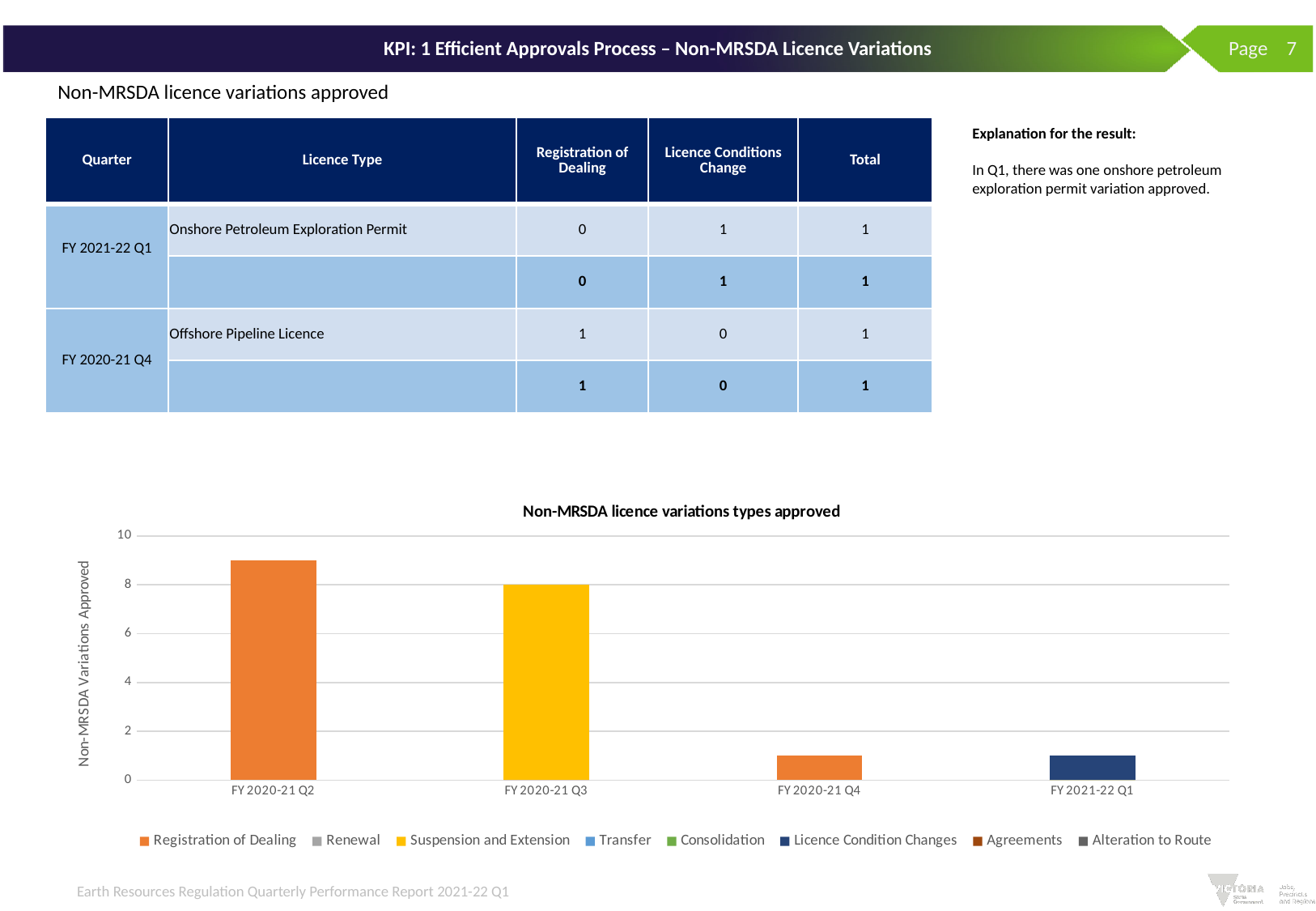
Do the bar values in the 'Non-MRSDA licence variations types approved' chart generally rise or fall from FY 2020-21 Q2 to FY 2021-22 Q1? fall According to the legend, which series does the yellow bar for FY 2020-21 Q3 represent in the 'Non-MRSDA licence variations types approved' chart? Suspension and Extension What kind of chart is shown under the title 'Non-MRSDA licence variations types approved'? bar chart In the 'Non-MRSDA licence variations types approved' chart, which bar is taller: FY 2020-21 Q2 or FY 2020-21 Q3? FY 2020-21 Q2 How many quarters are shown on the x axis of the 'Non-MRSDA licence variations types approved' chart? 4 In the 'Non-MRSDA licence variations types approved' chart, is the value for FY 2021-22 Q1 greater or less than 2? less Which quarter has the highest bar in the 'Non-MRSDA licence variations types approved' chart? FY 2020-21 Q2 In the 'Non-MRSDA licence variations types approved' chart, is the value for FY 2020-21 Q4 greater or less than 2? less In the 'Non-MRSDA licence variations types approved' chart, what is the value of the bar for FY 2020-21 Q3? 8 In the 'Non-MRSDA licence variations types approved' chart, is the value for FY 2020-21 Q2 greater or less than 8? greater What is the y-axis title of the 'Non-MRSDA licence variations types approved' chart? Non-MRSDA Variations Approved How many series does the legend of the 'Non-MRSDA licence variations types approved' chart list? 8